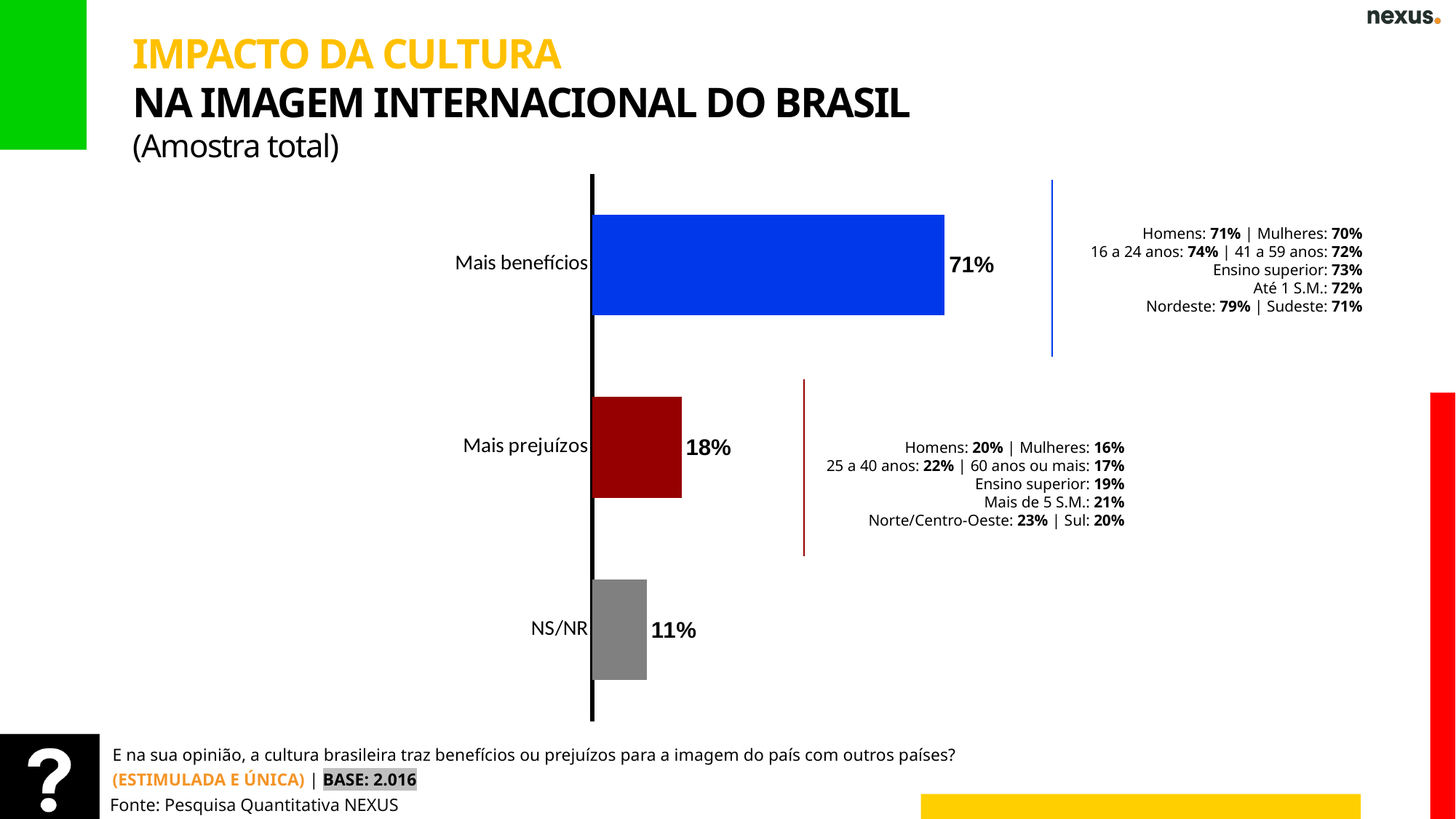
Which is larger, Mais prejuízos or NS/NR? Mais prejuízos What is the difference between Mais prejuízos and NS/NR? 7% What colour is the bar for Mais prejuízos? Dark red What is the value for Mais prejuízos? 18% What is the base (sample size) shown on the slide? 2.016 What kind of chart is shown on the slide? Bar chart Which category has the highest value? Mais benefícios What is the value for Mais benefícios? 71% What is the difference between Mais benefícios and Mais prejuízos? 53% How many categories are shown in the chart? 3 Which category has the lowest value? NS/NR What is the value for NS/NR? 11%